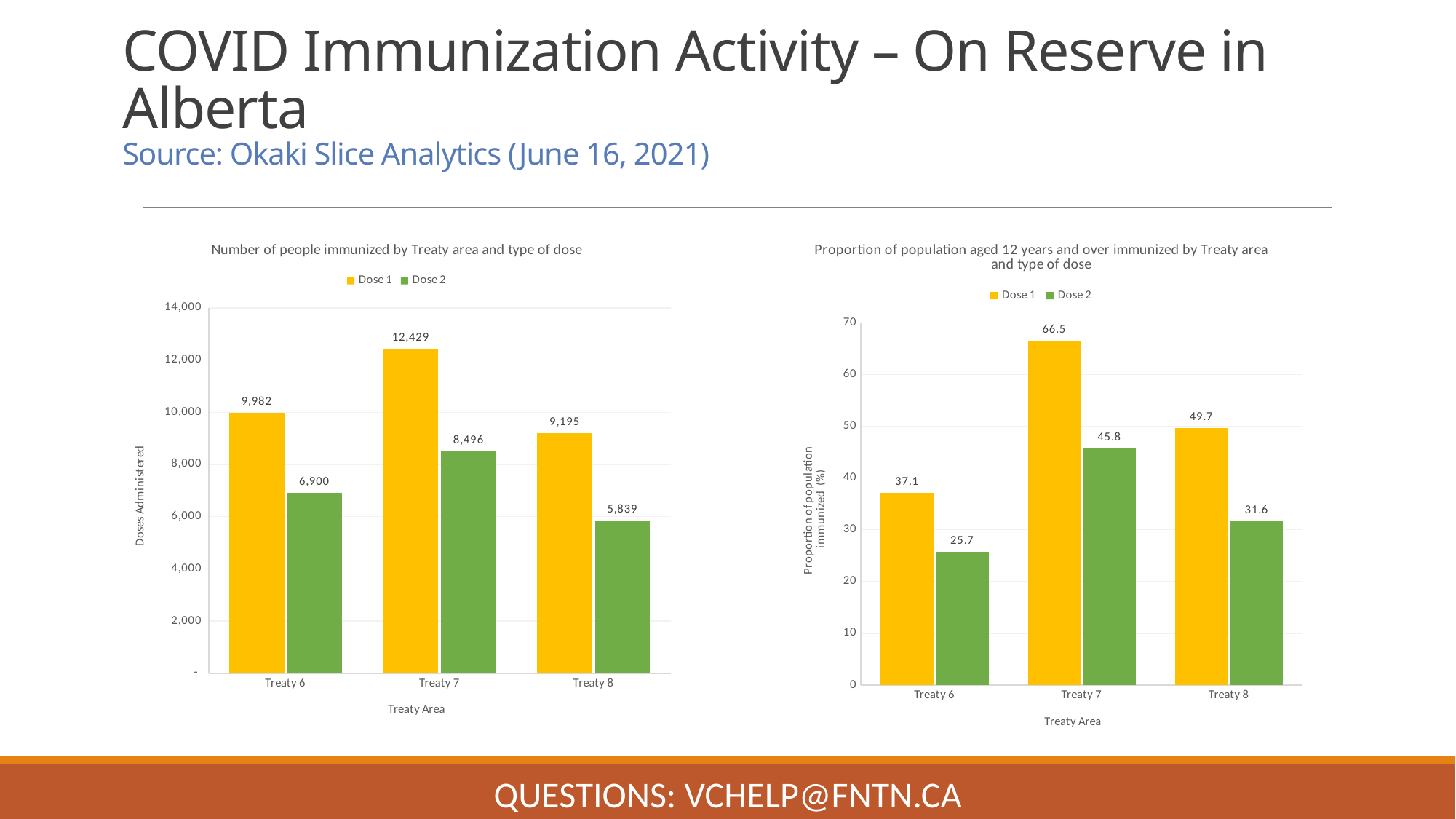
In the left chart (Number of people immunized by Treaty area and type of dose), what kind of chart is it? Bar chart In the right chart (Proportion of population aged 12 years and over immunized), which Treaty area has the highest Dose 1 value? Treaty 7 In the left chart (Number of people immunized by Treaty area and type of dose), which Treaty area has the lowest Dose 2 value? Treaty 8 In the right chart (Proportion of population aged 12 years and over immunized), which is larger: the Dose 2 value for Treaty 7 or the Dose 2 value for Treaty 8? Treaty 7 In the left chart (Number of people immunized by Treaty area and type of dose), what is the Dose 1 value for Treaty 7? 12,429 In the left chart (Number of people immunized by Treaty area and type of dose), how many Treaty areas are shown on the x axis? 3 In the left chart (Number of people immunized by Treaty area and type of dose), what is the difference between Dose 1 and Dose 2 for Treaty 6? 3,082 In the left chart (Number of people immunized by Treaty area and type of dose), what is the Dose 2 value for Treaty 8? 5,839 In the right chart (Proportion of population aged 12 years and over immunized), how many series does the legend list? 2 In the right chart (Proportion of population aged 12 years and over immunized), what is the Dose 2 value for Treaty 6? 25.7 In the right chart (Proportion of population aged 12 years and over immunized), what is the Dose 1 value for Treaty 8? 49.7 In the right chart (Proportion of population aged 12 years and over immunized), what is the label of the y axis? Proportion of population immunized (%)